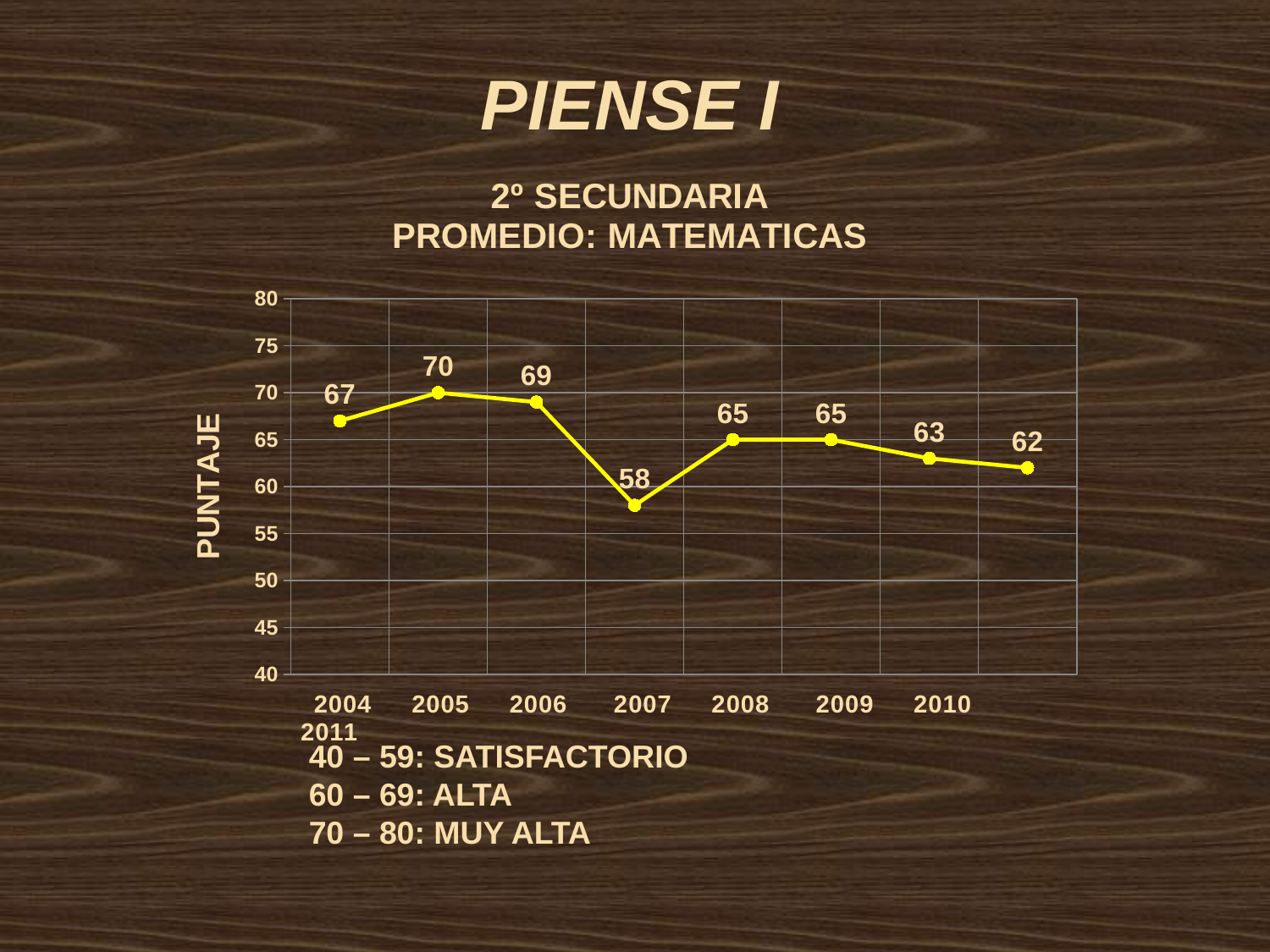
What is the PUNTAJE value for 2010? 63 What is the PUNTAJE value for 2004? 67 Which year has the lowest PUNTAJE? 2007 What is the difference between the PUNTAJE for 2005 and 2007? 12 Which year has a higher PUNTAJE, 2006 or 2008? 2006 What is the PUNTAJE value for 2007? 58 What is the label on the vertical axis of the chart? PUNTAJE What kind of chart is shown on the slide? line chart How many years are plotted on the chart? 8 What is the difference between the PUNTAJE for 2004 and 2011? 5 Is the PUNTAJE for 2007 greater or less than 60? less Which year has the highest PUNTAJE? 2005